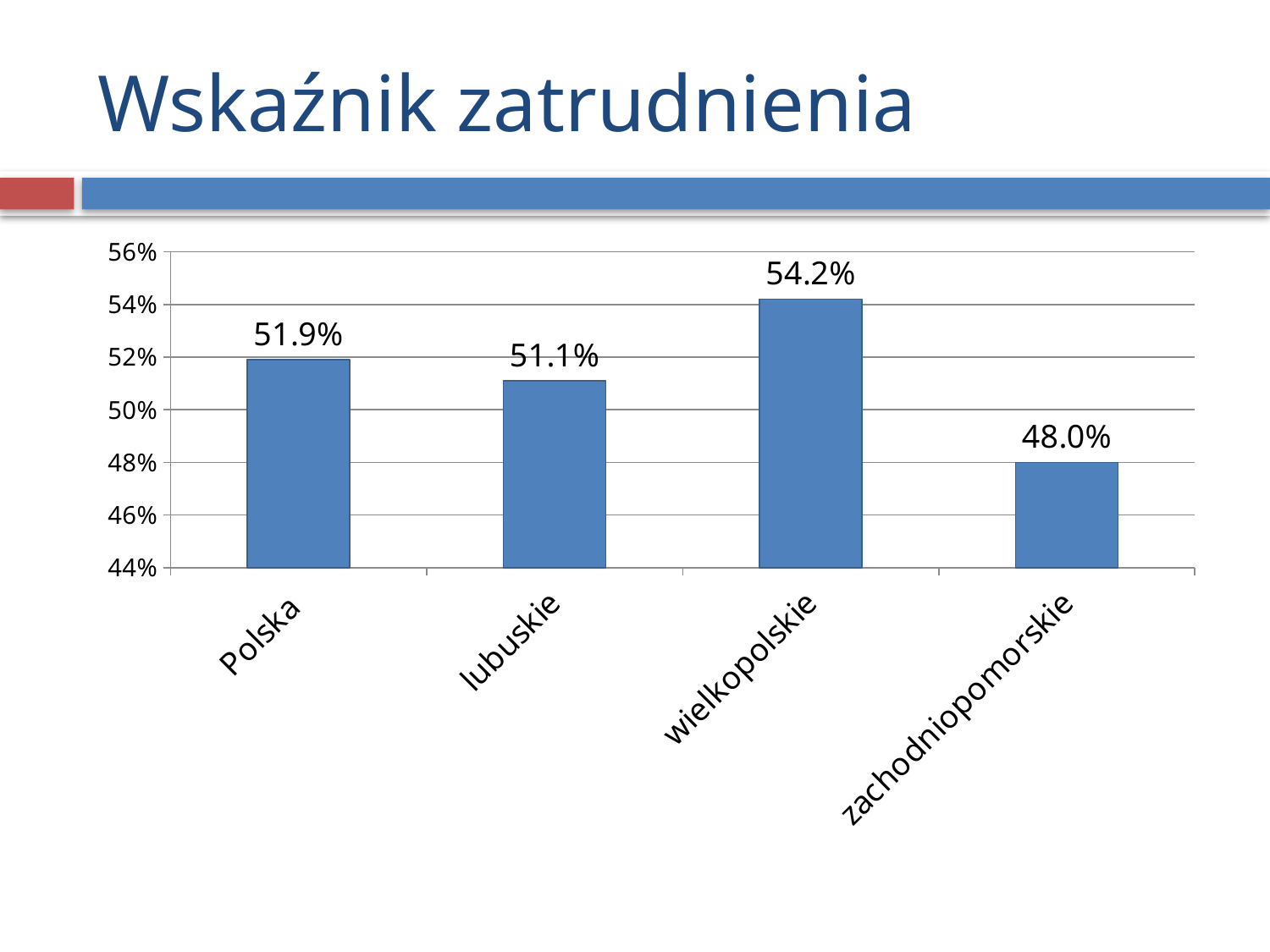
What is the value for zachodniopomorskie? 48.0% What is the value for lubuskie? 51.1% What is the value for Polska? 51.9% How many categories are shown in the chart? 4 Is the value for zachodniopomorskie greater or less than 50%? less Which category has the lowest value? zachodniopomorskie What is the difference between the values for wielkopolskie and zachodniopomorskie? 6.2% What is the difference between the values for Polska and lubuskie? 0.8% What is the value for wielkopolskie? 54.2% Which category has the highest value? wielkopolskie Which is larger, the value for Polska or the value for lubuskie? Polska What kind of chart is shown on the slide? bar chart